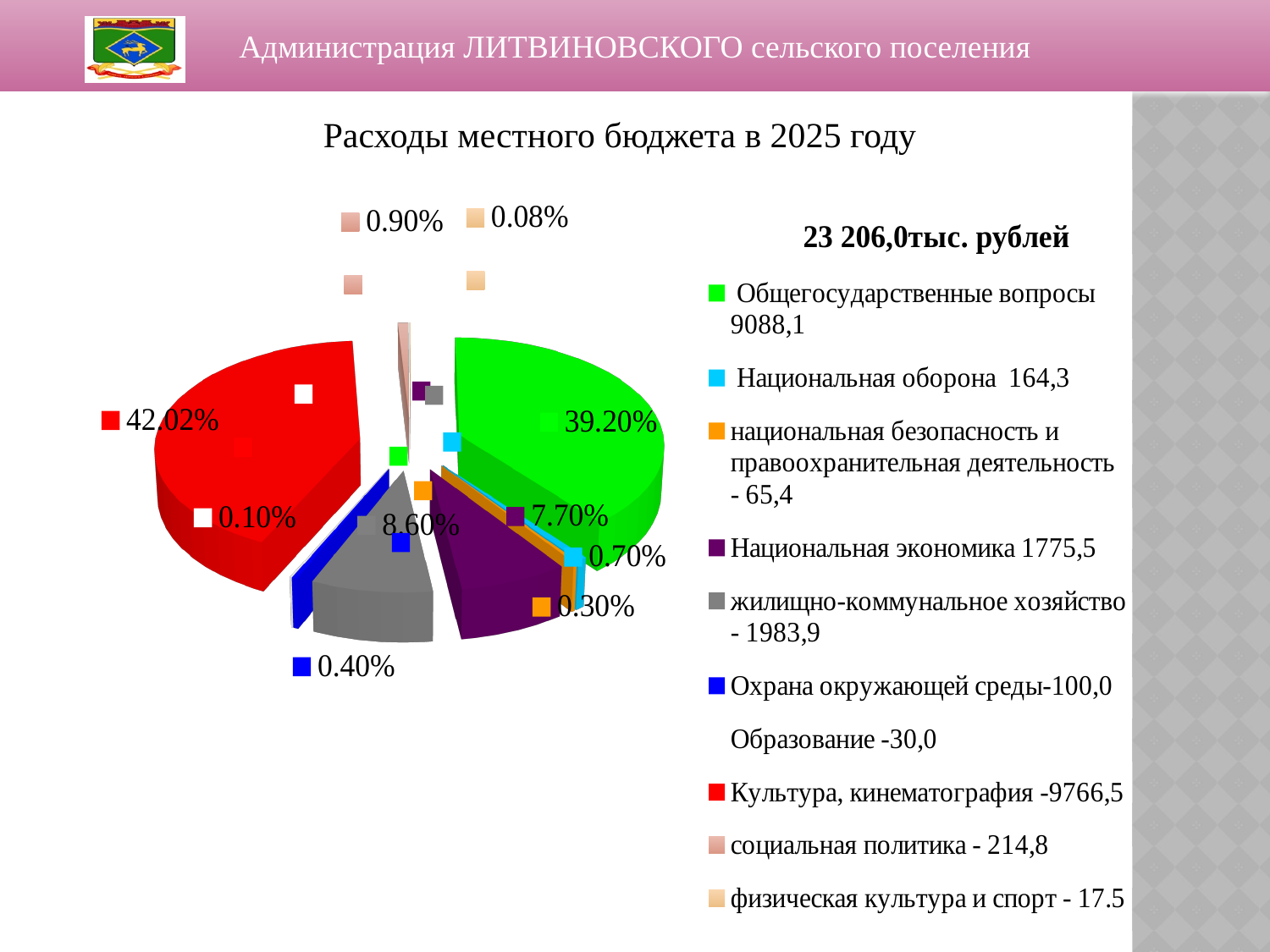
What total amount is shown above the legend? 23 206,0тыс. рублей What percentage share does the purple slice (Национальная экономика) have? 7.70% What percentage share does the red slice (Культура, кинематография) have? 42.02% Which category has the smallest share of the pie? физическая культура и спорт What is the title of the chart? Расходы местного бюджета в 2025 году What percentage share does the gray slice (жилищно-коммунальное хозяйство) have? 8.60% How many categories does the legend list? 10 What amount is listed in the legend for Национальная оборона? 164,3 What kind of chart is shown on the slide? pie chart Which is larger: the share for Национальная экономика or the share for жилищно-коммунальное хозяйство? жилищно-коммунальное хозяйство What percentage share does the green slice (Общегосударственные вопросы) have? 39.20% Which category has the largest share of the pie? Культура, кинематография